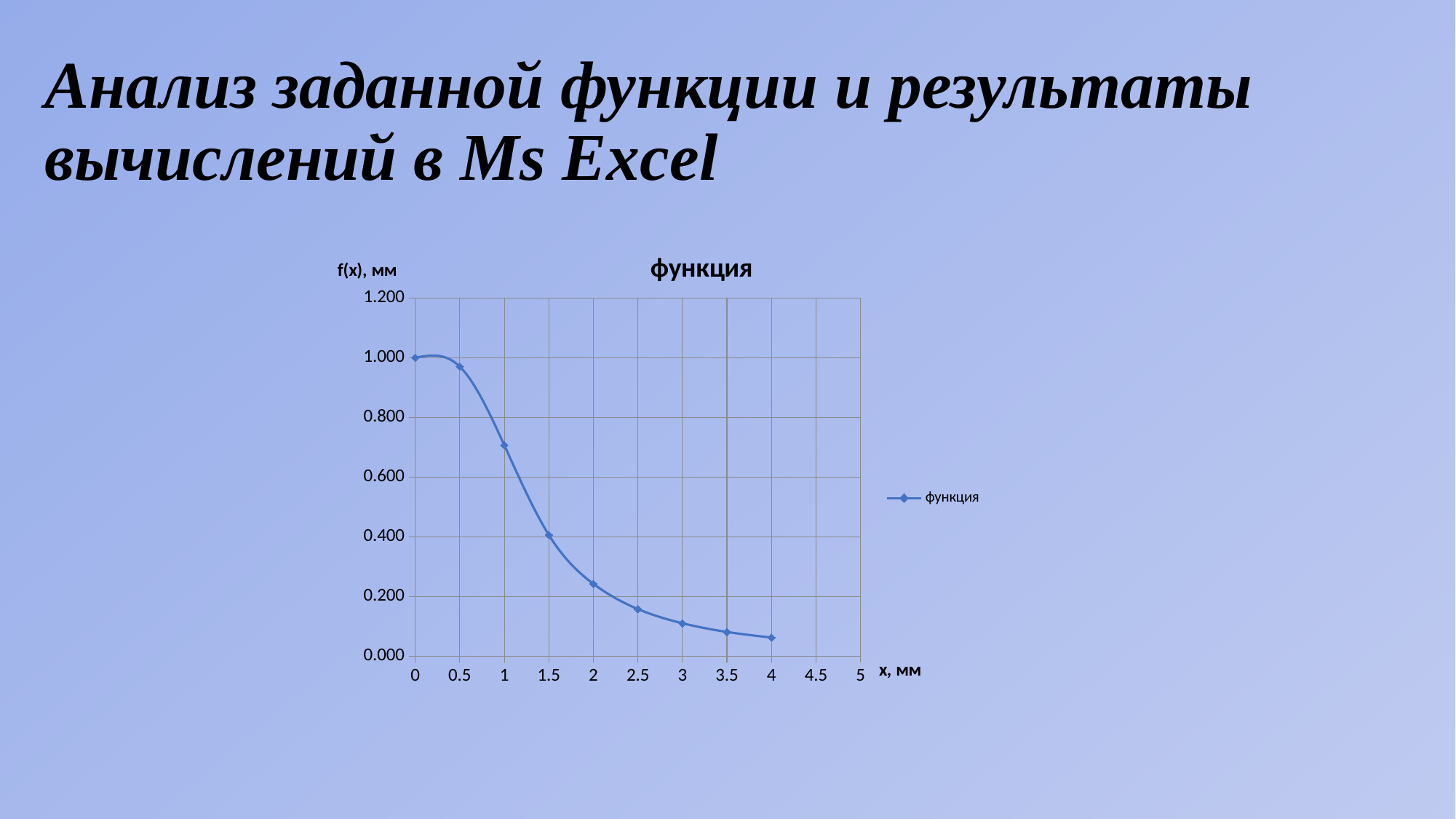
How many data points are plotted on the line? 9 How many series does the legend list? 1 At which value of x is the function lowest? 4 Is the value of the function at x = 2 greater or less than 0.400? less What is the value of the function at x = 0? 1.000 What kind of chart is shown on the slide? line chart Is the value of the function at x = 1 greater or less than 0.600? greater Do the values of the function rise or fall as x increases? fall Which is larger, the value of the function at x = 1.5 or at x = 3? x = 1.5 What is the title of the chart? функция What is the label of the vertical axis of the chart? f(x), мм At which value of x is the function highest? 0